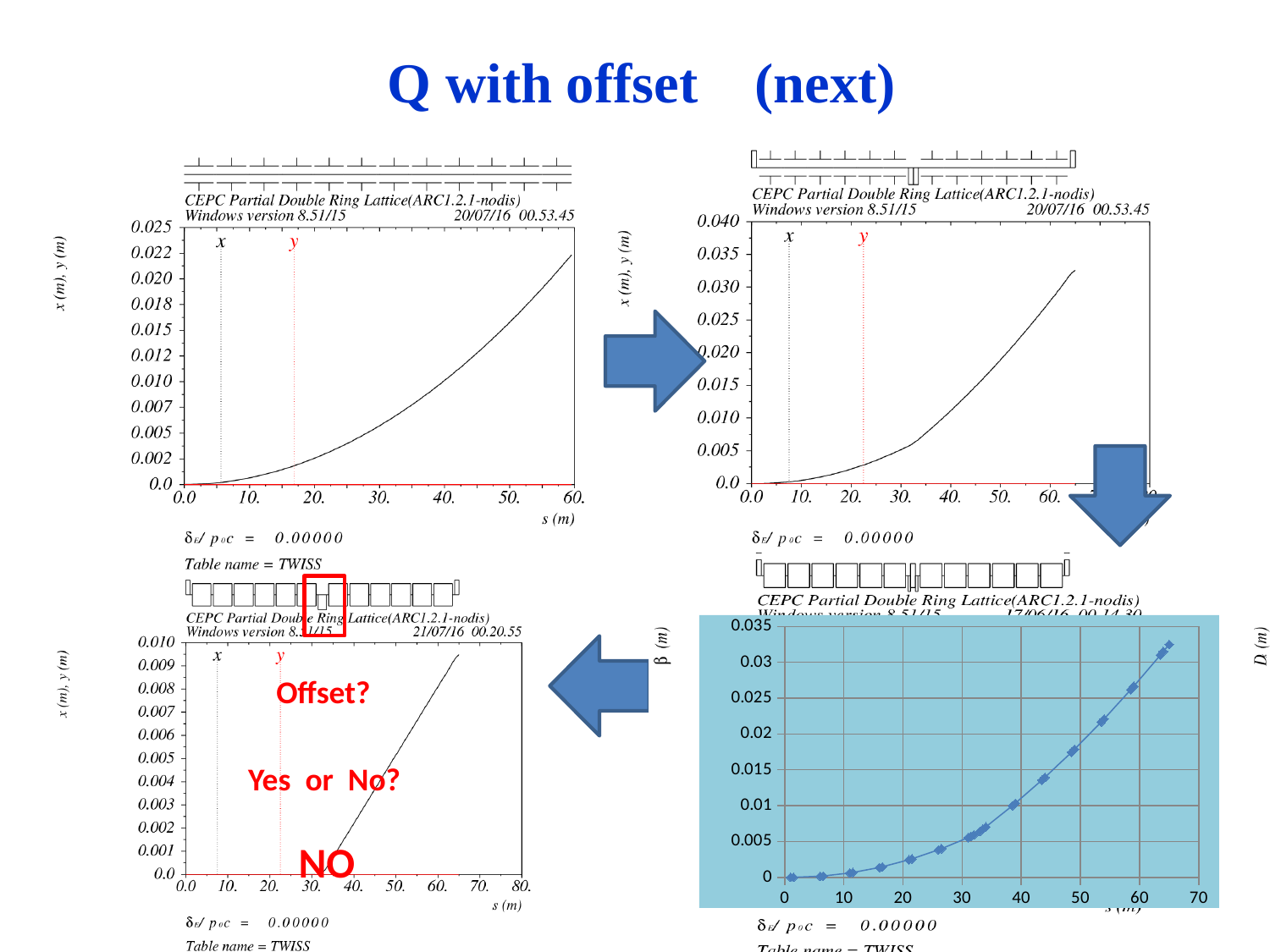
In the bottom-right chart with the blue background, is the value at x = 60 greater or less than 0.02? greater In the bottom-left chart, is the value of x at s = 60 greater or less than 0.007? greater In the top-right chart, is the value of x at s = 60 greater or less than 0.025? greater In the top-left chart, how many series are labelled in the legend? 2 In the bottom-right chart with the blue background, what is the highest value shown on the x axis? 70 In the top-left chart, does the x curve rise or fall as s increases? rise What kind of chart is the bottom-right chart with the blue background? line chart In the bottom-right chart with the blue background, do the values rise or fall as the x axis increases? rise In the bottom-right chart with the blue background, what is the highest value shown on the y axis? 0.035